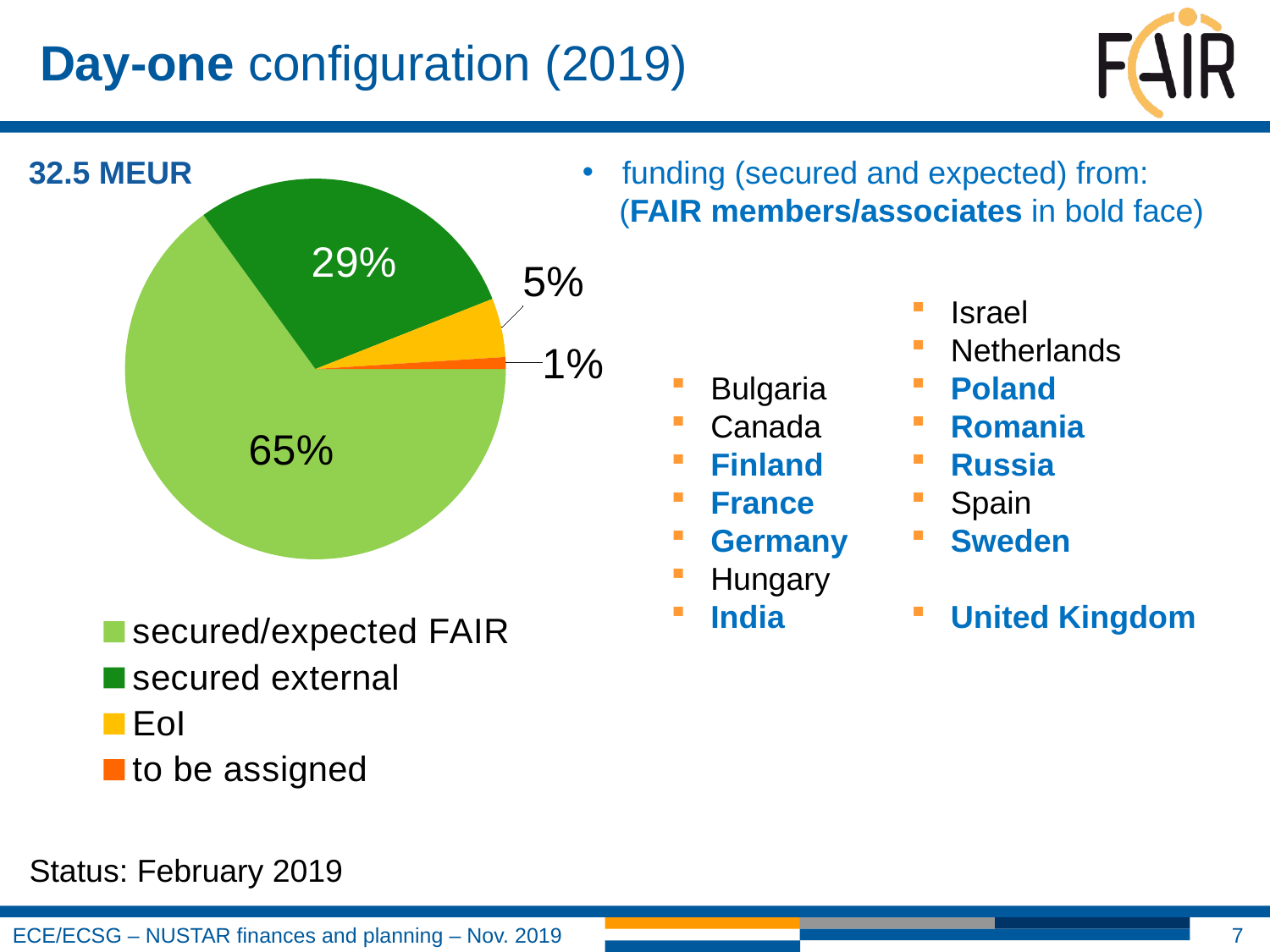
What total amount is stated above the pie chart? 32.5 MEUR Which is larger, the 'EoI' slice or the 'to be assigned' slice? EoI What colour is the 'EoI' slice in the pie chart? yellow What share of the pie does 'secured/expected FAIR' represent? 65% What share of the pie does 'secured external' represent? 29% What kind of chart is shown on the slide? pie chart What share of the pie does 'EoI' represent? 5% How many slices does the pie chart have? 4 Which category has the largest slice of the pie? secured/expected FAIR What is the difference in percentage points between 'secured/expected FAIR' and 'secured external'? 36% Which category has the smallest slice of the pie? to be assigned